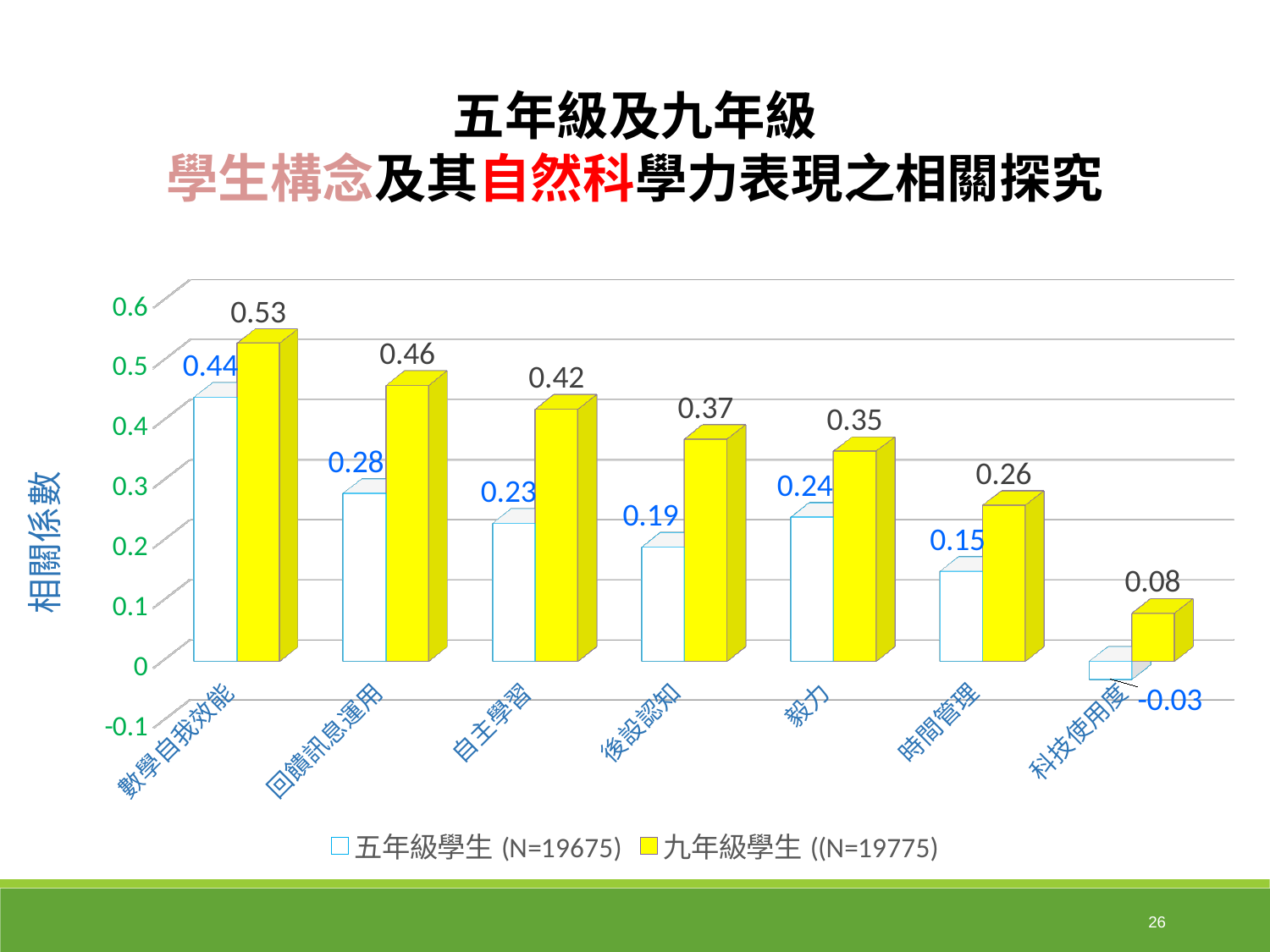
Which category has the highest value for 九年級學生? 數學自我效能 What is the label of the y axis? 相關係數 What kind of chart is shown on the slide? Bar chart What is the difference between the 九年級學生 and 五年級學生 values in the 自主學習 category? 0.19 Which is larger in the 毅力 category: the value for 五年級學生 or for 九年級學生? 九年級學生 What is the value for 五年級學生 in the 科技使用度 category? -0.03 How many series does the legend list? 2 Which category has the lowest value for 五年級學生? 科技使用度 Do the values for 九年級學生 rise or fall from left to right along the x axis? Fall How many categories are shown on the x axis? 7 What is the correlation coefficient for 五年級學生 in the 回饋訊息運用 category? 0.28 What is the correlation coefficient for 九年級學生 in the 數學自我效能 category? 0.53